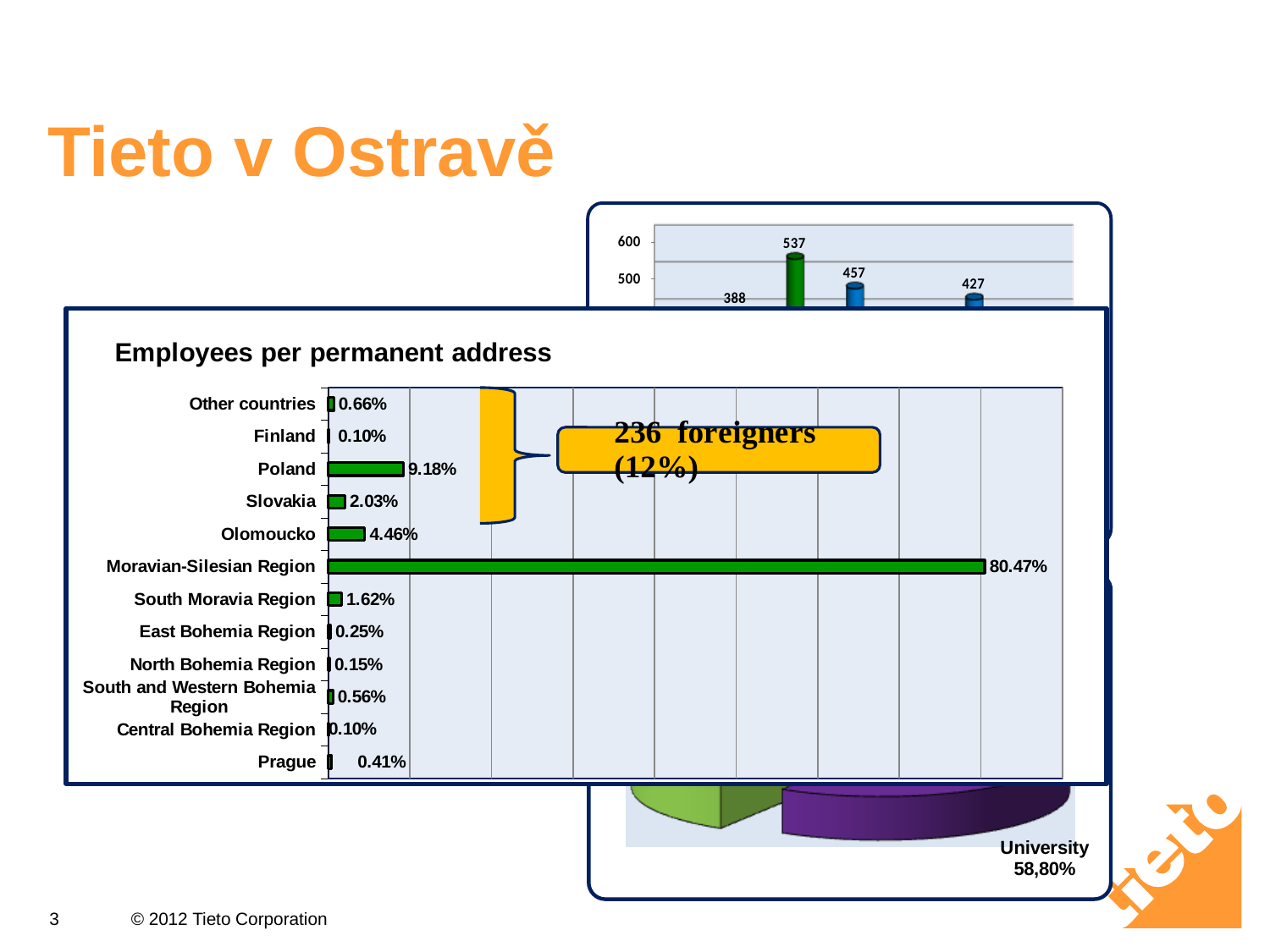
In the bar chart at the top right of the slide, what is the highest data label shown? 537 How many categories are shown in the 'Employees per permanent address' chart? 12 In the 'Employees per permanent address' chart, which is larger, the value for Slovakia or the value for South Moravia Region? Slovakia In the 'Employees per permanent address' chart, what does the callout say about foreigners? 236 foreigners (12%) In the 'Employees per permanent address' chart, what is the value for Prague? 0.41% What kind of chart is the 'Employees per permanent address' chart? bar chart In the 'Employees per permanent address' chart, which category has the highest value? Moravian-Silesian Region In the 'Employees per permanent address' chart, what is the value for Olomoucko? 4.46% In the 'Employees per permanent address' chart, what is the value for the Moravian-Silesian Region? 80.47% In the 'Employees per permanent address' chart, what is the difference between the values for Poland and Olomoucko? 4.72% In the pie chart at the bottom right of the slide, what is the value shown for University? 58,80% In the 'Employees per permanent address' chart, what is the value for Poland? 9.18%